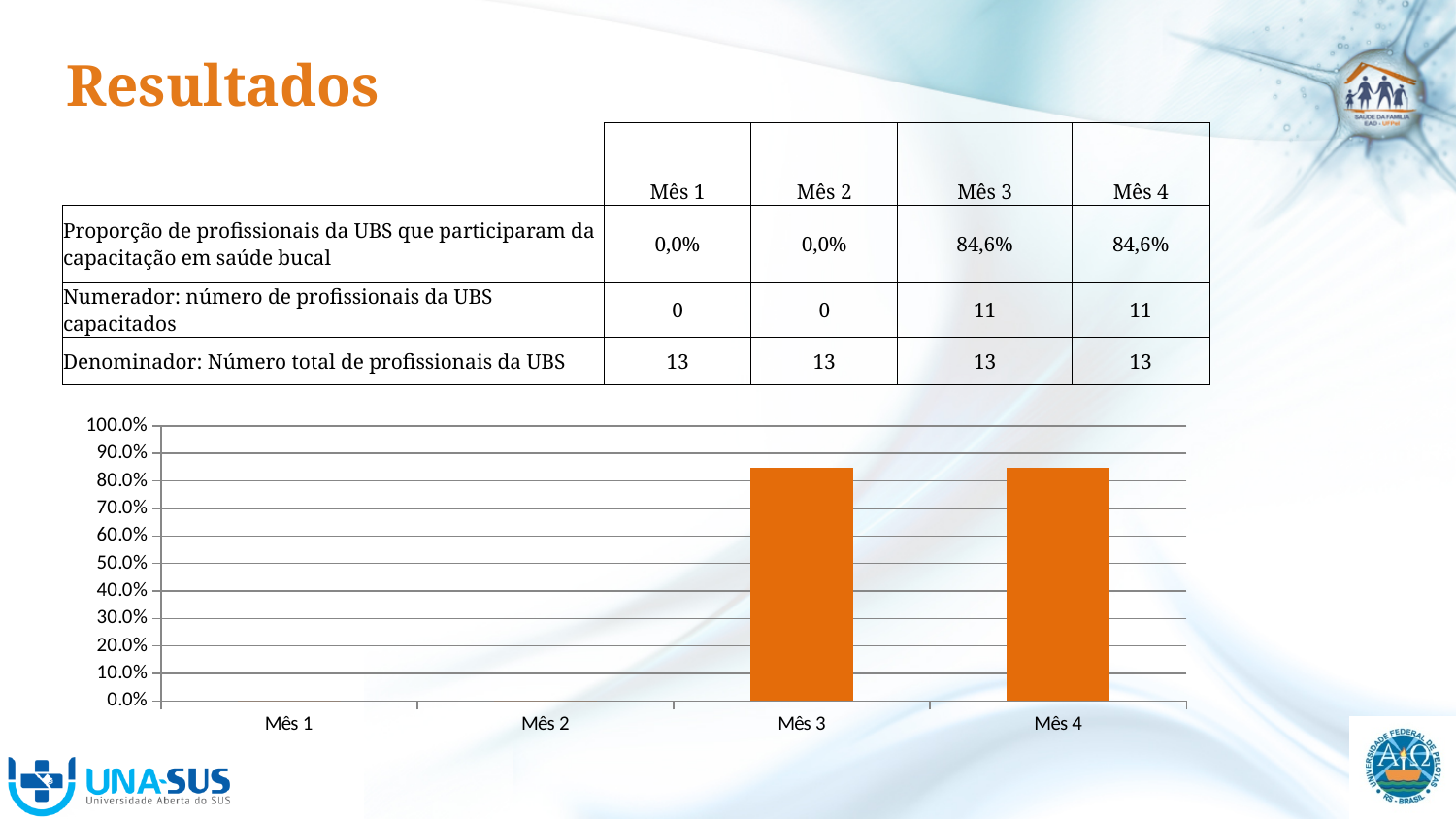
What colour are the bars in the chart? orange How many categories (months) are shown on the x axis of the chart? 4 What kind of chart is shown on the slide? bar chart What is the highest tick value shown on the chart's vertical axis? 100.0% Do the values in the chart rise or fall from Mês 1 to Mês 4? rise Is the value for Mês 3 in the chart greater or less than 50.0%? greater According to the slide, what is the proportion plotted for Mês 1? 0,0% Is the value for Mês 4 in the chart greater or less than 90.0%? less Which has the larger value in the chart, Mês 2 or Mês 4? Mês 4 Is the value for Mês 3 in the chart greater or less than 80.0%? greater According to the slide, what is the proportion plotted for Mês 3? 84,6% Which months show no visible bar in the chart? Mês 1 and Mês 2